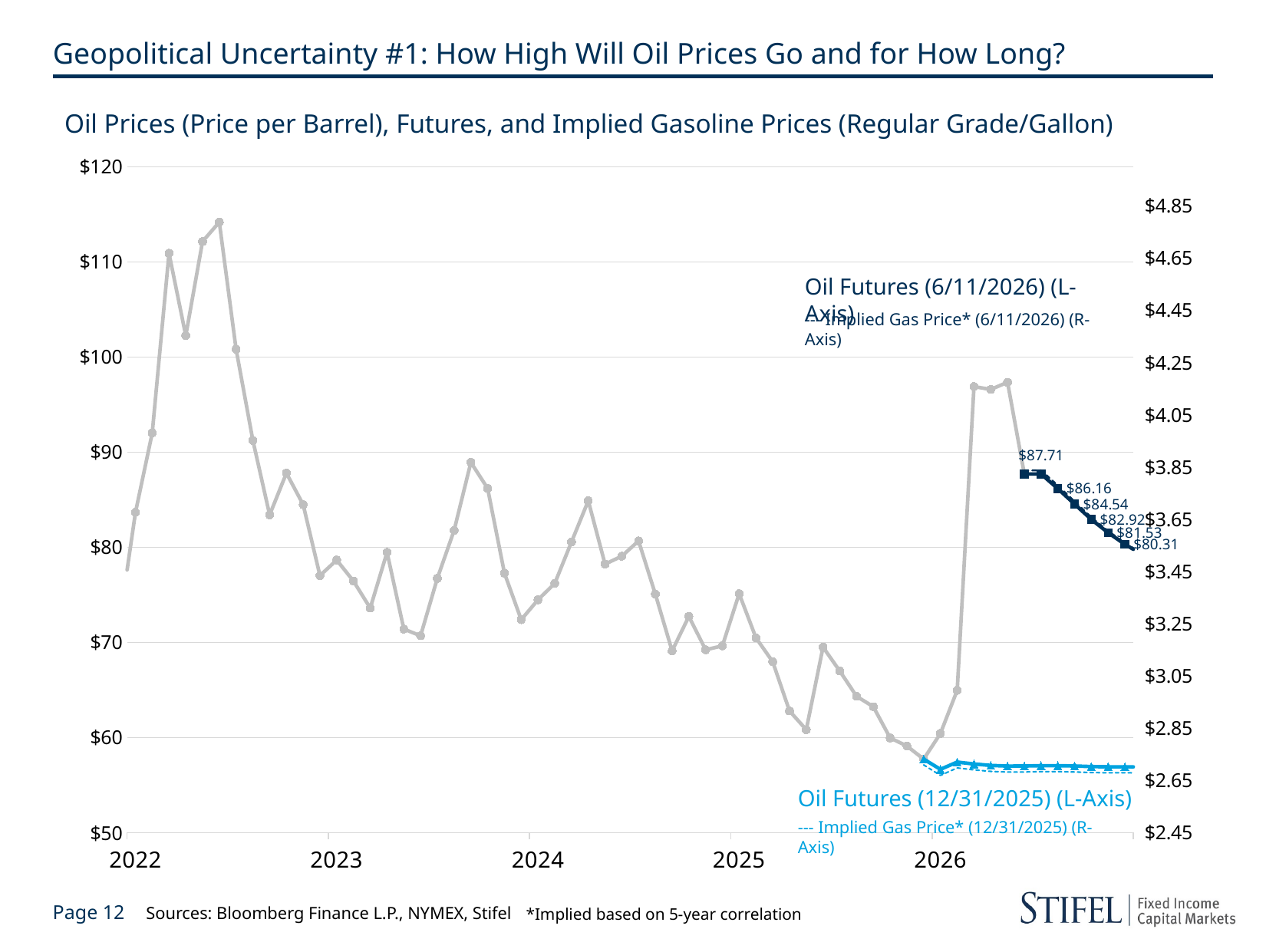
Is the peak oil price in 2022 greater or less than $110? greater Is the value of the Oil Futures (12/31/2025) series greater or less than $60? less What is the title of the chart? Oil Prices (Price per Barrel), Futures, and Implied Gasoline Prices (Regular Grade/Gallon) What is the first labeled value of the Oil Futures (6/11/2026) series? $87.71 What is the lowest labeled value on the Oil Futures (6/11/2026) series? $80.31 What is the difference between the labeled values $86.16 and $84.54 on the Oil Futures (6/11/2026) series? $1.62 How many data labels are printed on the Oil Futures (6/11/2026) series? 6 What is the last labeled value of the Oil Futures (6/11/2026) series? $80.31 What is the difference between the first ($87.71) and last ($80.31) labeled values of the Oil Futures (6/11/2026) series? $7.40 Do the values of the Oil Futures (6/11/2026) series rise or fall from left to right? fall What is the highest labeled value on the Oil Futures (6/11/2026) series? $87.71 What kind of chart is shown on the slide? line chart